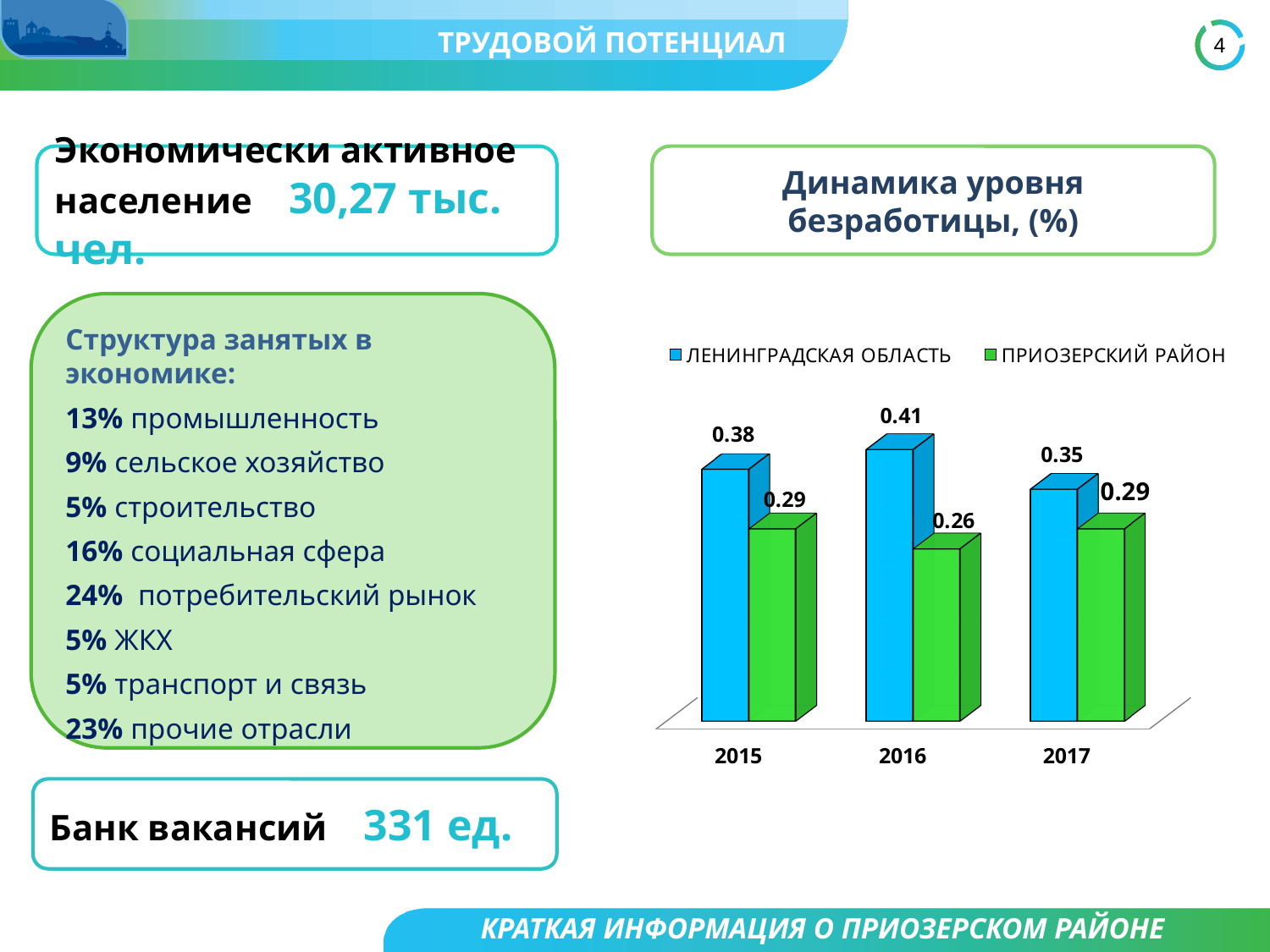
What is the unemployment rate for ЛЕНИНГРАДСКАЯ ОБЛАСТЬ in 2016? 0.41 In which year is the unemployment rate for ЛЕНИНГРАДСКАЯ ОБЛАСТЬ highest? 2016 Which has the higher unemployment rate in 2015, ЛЕНИНГРАДСКАЯ ОБЛАСТЬ or ПРИОЗЕРСКИЙ РАЙОН? ЛЕНИНГРАДСКАЯ ОБЛАСТЬ What is the unemployment rate for ПРИОЗЕРСКИЙ РАЙОН in 2015? 0.29 What is the unemployment rate for ПРИОЗЕРСКИЙ РАЙОН in 2016? 0.26 What kind of chart is used to show the unemployment rate dynamics? bar chart How many years are shown on the x axis of the chart? 3 How many series does the chart legend list? 2 What is the title of the chart on the right side of the slide? Динамика уровня безработицы, (%) What is the unemployment rate for ЛЕНИНГРАДСКАЯ ОБЛАСТЬ in 2017? 0.35 What is the difference between the ЛЕНИНГРАДСКАЯ ОБЛАСТЬ and ПРИОЗЕРСКИЙ РАЙОН unemployment rates in 2016? 0.15 In which year is the unemployment rate for ПРИОЗЕРСКИЙ РАЙОН lowest? 2016